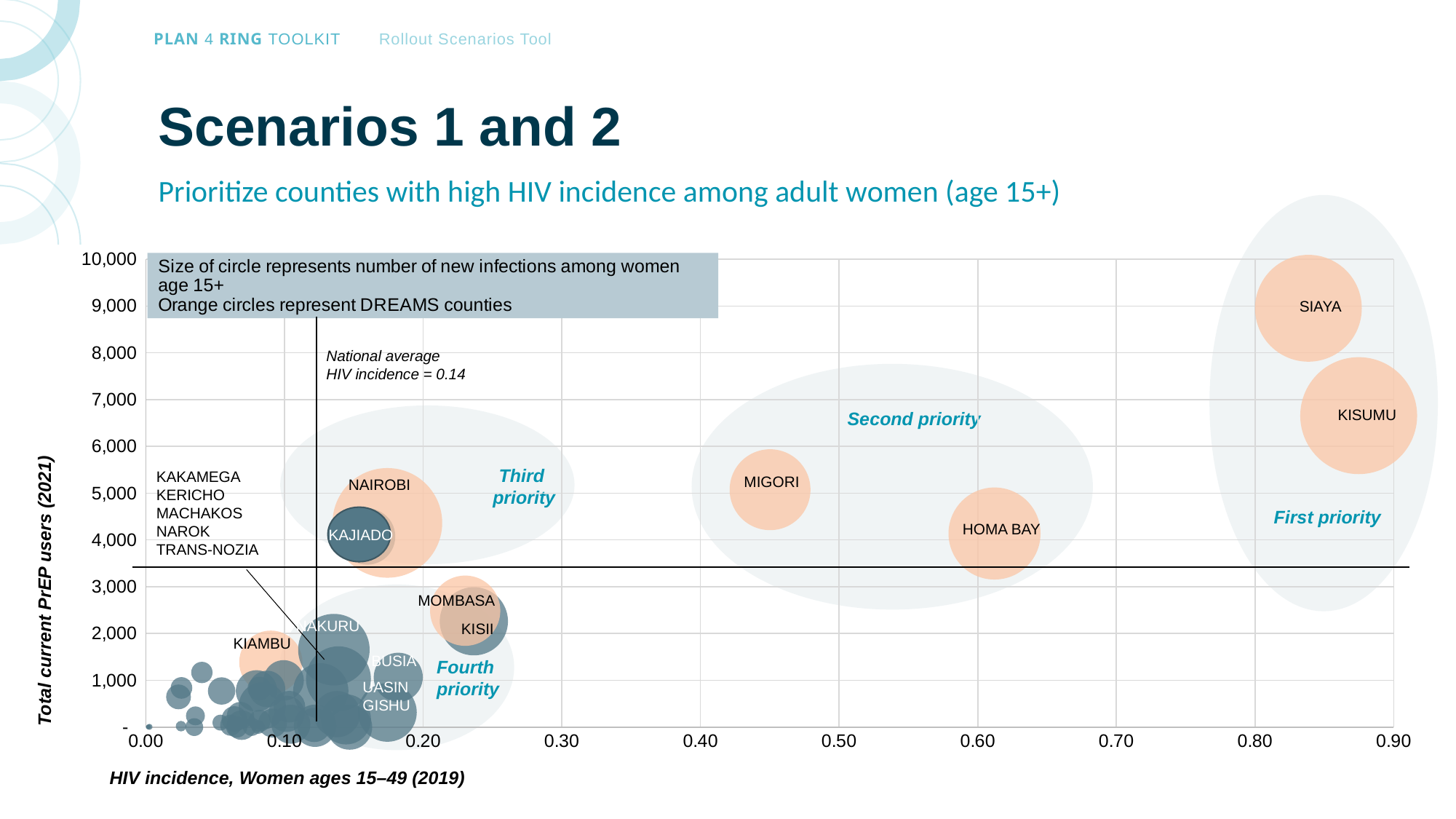
What kind of chart is shown on the slide? Bubble chart Is the total current PrEP users value for Siaya greater or less than 8,000? greater Which county has the highest HIV incidence among women ages 15–49? Kisumu According to the chart note, what do orange circles represent? DREAMS counties What is the national average HIV incidence noted on the chart? 0.14 Is the HIV incidence value for Migori greater or less than 0.50? less Is the total current PrEP users value for Mombasa greater or less than 3,000? less Which county has a higher HIV incidence, Homa Bay or Migori? Homa Bay Which county has more total current PrEP users, Migori or Homa Bay? Migori Which county has the highest total current PrEP users (2021)? Siaya